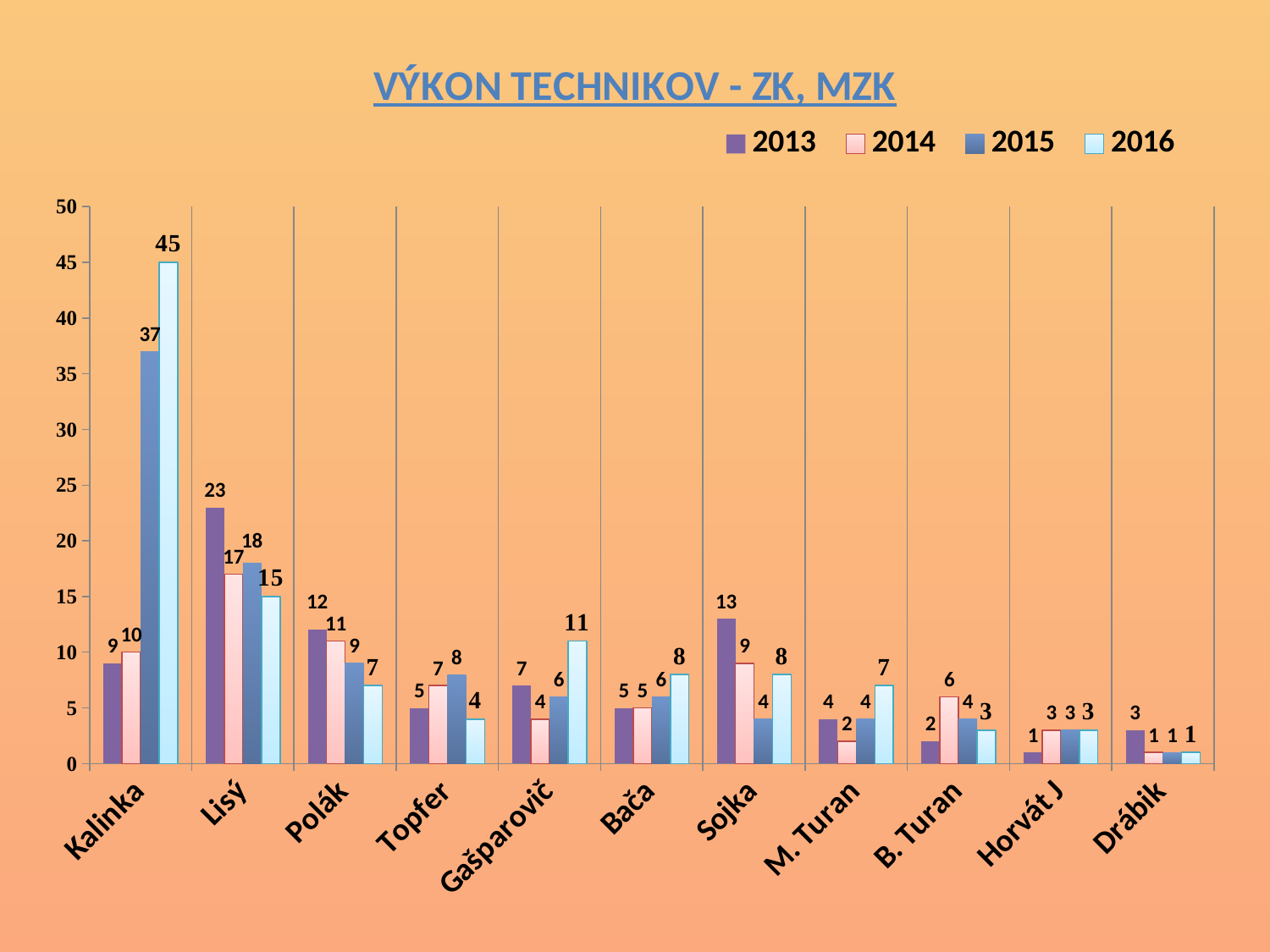
Which technician has the highest value in 2015? Kalinka What kind of chart is shown on the slide? Bar chart Which technician has the lowest value in 2013? Horvát J What is the value for Lisý in 2013? 23 Which is larger for Sojka: the 2013 value or the 2016 value? 2013 What is the title of the chart? VÝKON TECHNIKOV - ZK, MZK How many series does the legend list? 4 How many technicians (categories) are shown on the x axis? 11 What is the value for Gašparovič in 2014? 4 What is the value for Kalinka in 2016? 45 What is the difference between Kalinka's 2016 and 2015 values? 8 Do Kalinka's values rise or fall from 2013 to 2016? Rise